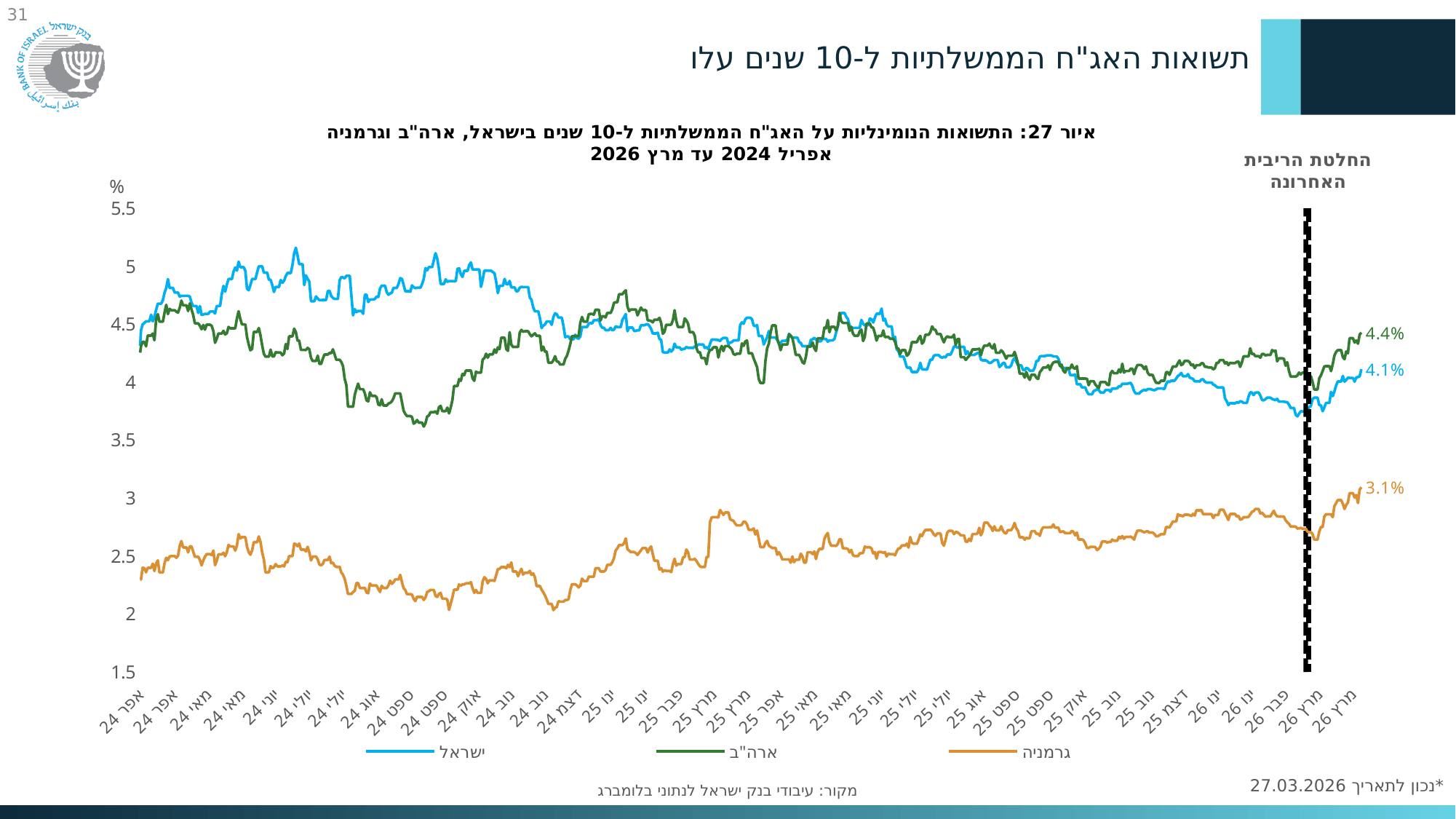
How many series does the legend list? 3 What does the label above the vertical dashed line on the chart say? החלטת הריבית האחרונה What is the latest labelled value for ארה"ב (US) at the right end of the chart? 4.4% What is the latest labelled value for ישראל (Israel) at the right end of the chart? 4.1% Which series has the highest value at the right end of the chart? ארה"ב Which series has the lowest value at the right end of the chart? גרמניה What type of chart is shown on the slide? Line chart What is the latest labelled value for גרמניה (Germany) at the right end of the chart? 3.1% What is the difference between the latest labelled values for ארה"ב and גרמניה? 1.3 percentage points What is the difference between the latest labelled values for ארה"ב and ישראל? 0.3 percentage points Does the גרמניה (Germany) line rise or fall overall from אפר 24 to מרץ 26? rise Is the value for גרמניה at the start of the chart (אפר 24) greater or less than 3? less